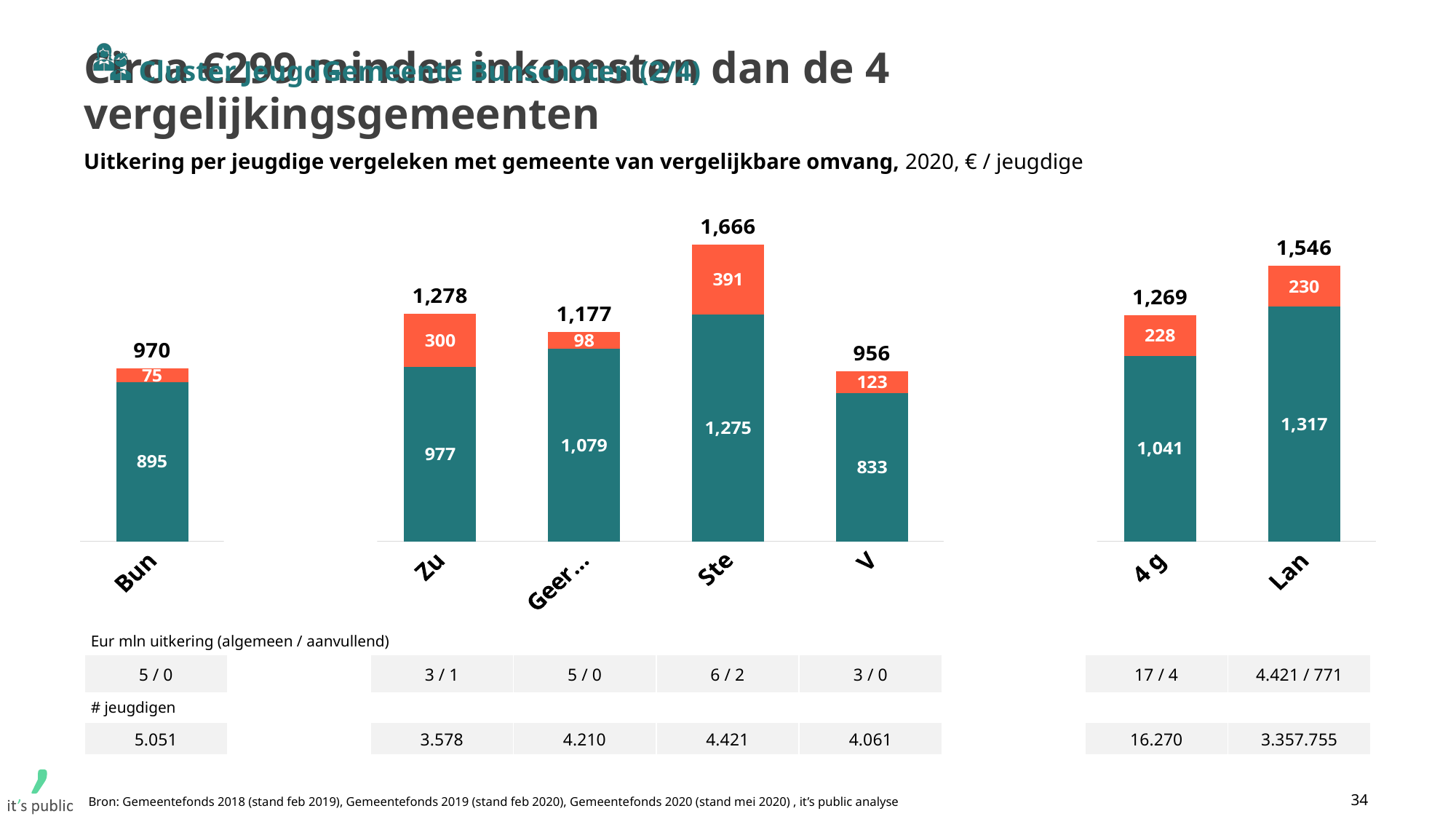
In the middle chart, which category has the lowest total? V In the left chart, what is the value of the teal (lower) segment of the Bun bar? 895 In the middle chart, which category has the highest total? Ste In the middle chart, what is the difference between the teal segments of Ste and V? 442 How many bars are shown in the middle chart? 4 In the middle chart, what is the difference between the totals for Ste and V? 710 In the middle chart, what is the value of the orange (upper) segment of the Zu bar? 300 What type of chart is used on this slide? Stacked bar chart In the right chart, which has the larger total, 4 g or Lan? Lan In the right chart, what is the value of the teal (lower) segment of the Lan bar? 1,317 In the left chart, what is the total value shown above the bar for Bun? 970 In the middle chart, what is the total value shown above the bar for Ste? 1,666